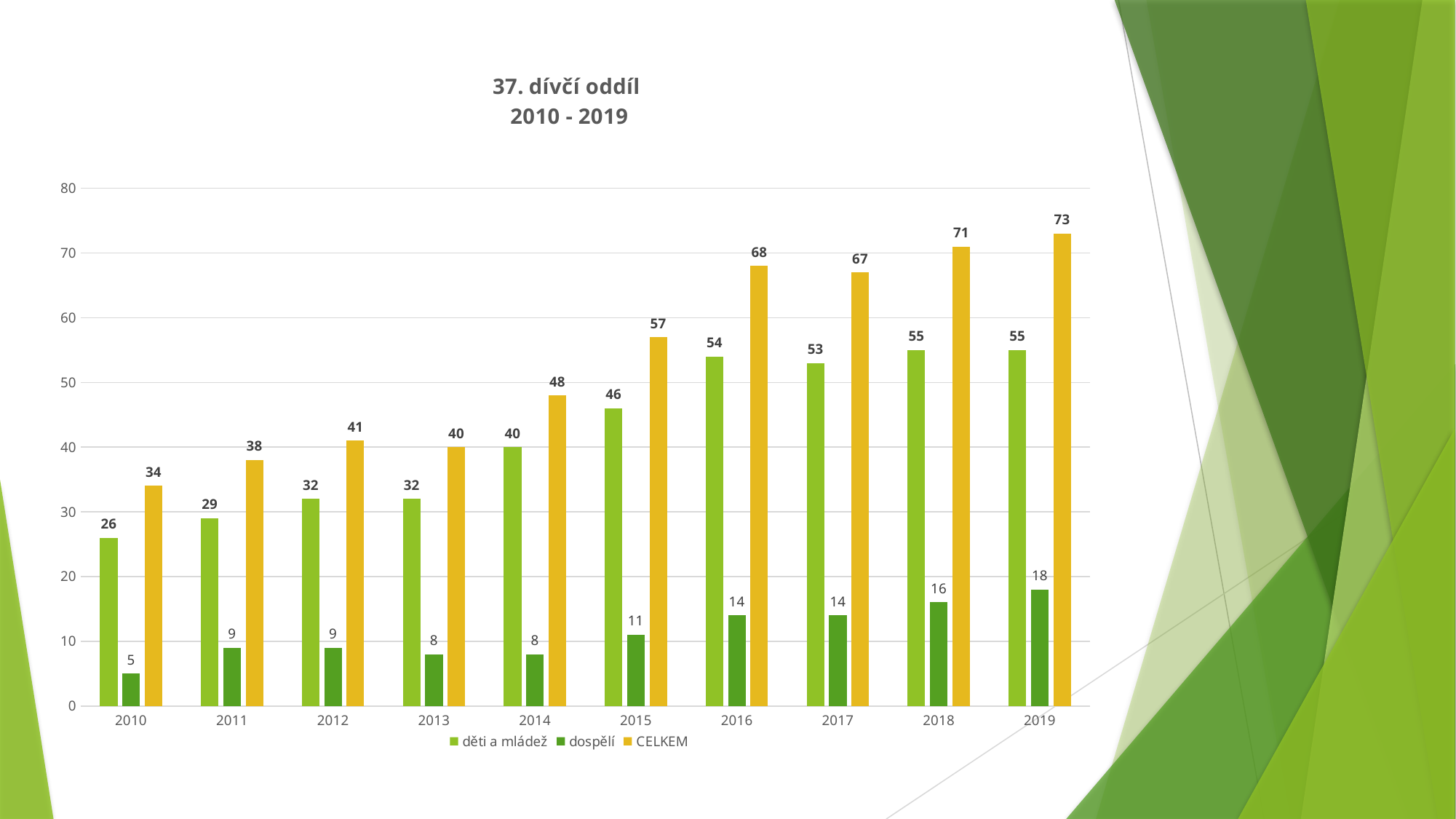
Is the CELKEM value for 2015 greater or less than 50? greater How many series does the legend list? 3 What is the value for děti a mládež in 2017? 53 Which is larger: děti a mládež in 2016 or děti a mládež in 2017? děti a mládež in 2016 What is the value for dospělí in 2013? 8 In which year is the CELKEM value highest? 2019 How many years are shown on the x axis? 10 What is the value for CELKEM in 2016? 68 What kind of chart is shown? bar chart What is the difference between the CELKEM values for 2019 and 2010? 39 In which year is the dospělí value lowest? 2010 What is the title of the chart? 37. dívčí oddíl 2010 - 2019